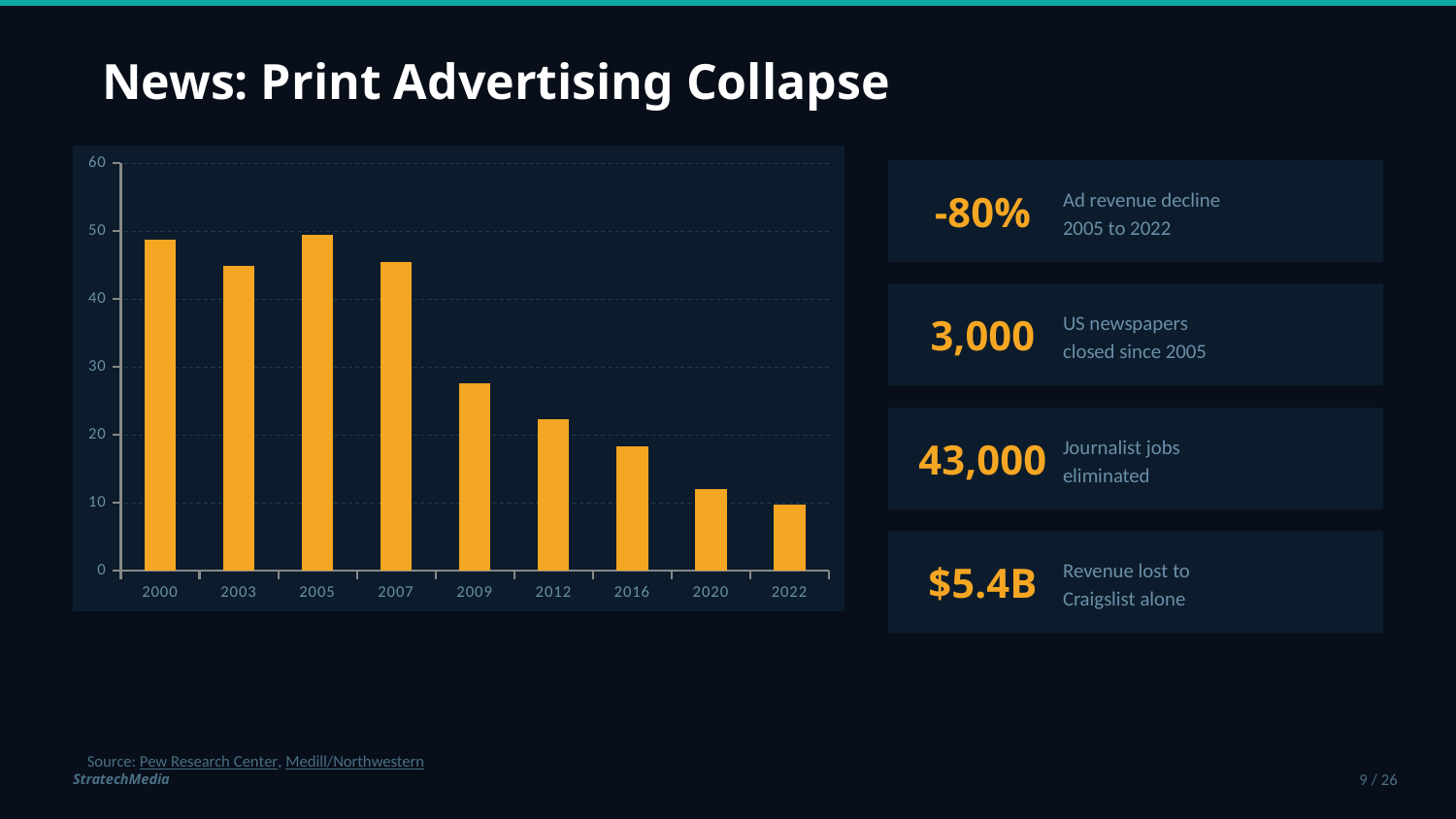
Is the value for 2012 greater or less than 20? greater What kind of chart is shown on the slide? bar chart Which year has the lowest bar in the chart? 2022 Do the values generally rise or fall from 2007 to 2022? fall How many years are shown on the x axis of the chart? 9 Is the value for 2016 greater or less than 20? less What colour are the bars in the chart? orange Is the value for 2009 greater or less than 30? less What is the title of the slide containing the chart? News: Print Advertising Collapse Which is larger, the value for 2003 or the value for 2009? 2003